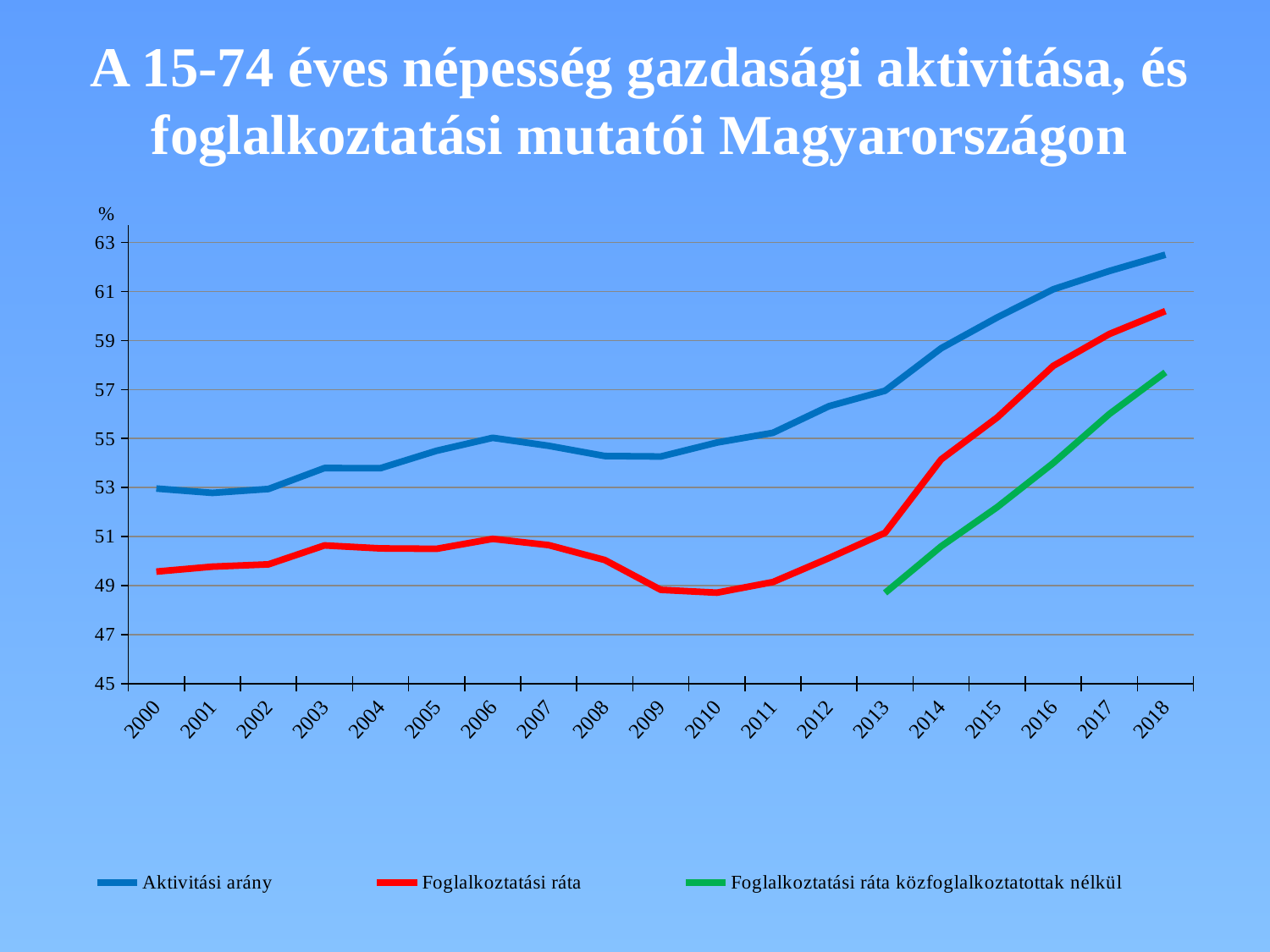
What unit is shown at the top of the y axis? % How many series does the legend list? 3 In 2018, which is larger: Aktivitási arány or Foglalkoztatási ráta? Aktivitási arány Does Aktivitási arány rise or fall from 2013 to 2018? rise Is the value for Foglalkoztatási ráta közfoglalkoztatottak nélkül in 2016 greater or less than 55? less In which year is Aktivitási arány at its highest? 2018 Is the value for Foglalkoztatási ráta in 2010 greater or less than 51? less Is the value for Aktivitási arány in 2000 greater or less than 55? less How many years are shown on the x axis? 19 Which series is drawn in green? Foglalkoztatási ráta közfoglalkoztatottak nélkül What kind of chart is shown on the slide? line chart